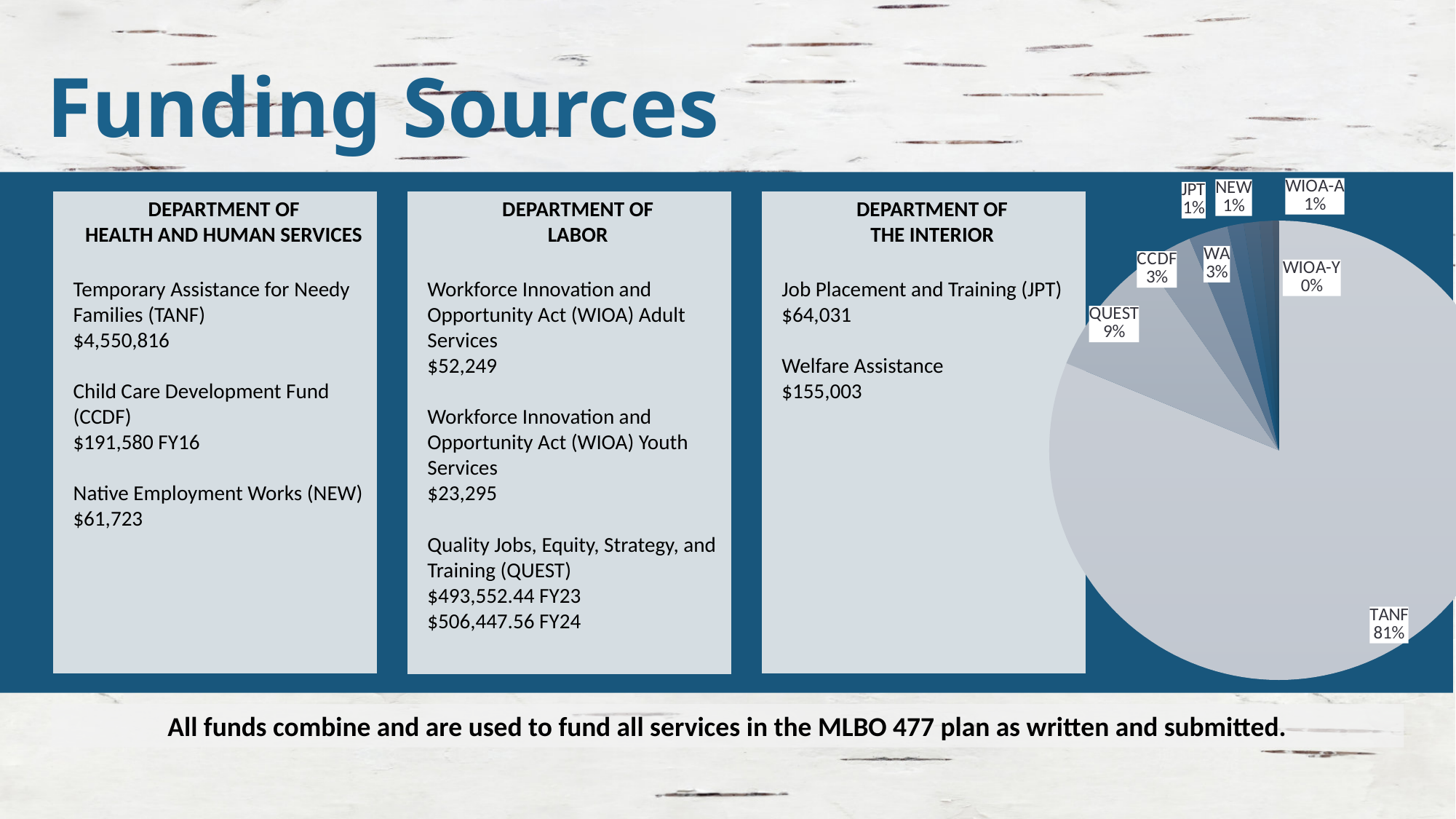
Which slice of the pie chart has the smallest labeled percentage? WIOA-Y Which is larger in the pie chart, QUEST or CCDF? QUEST How many slices are labeled in the pie chart? 8 What percentage is shown for JPT in the pie chart? 1% What kind of chart is shown on the slide? pie chart What percentage is shown for WA in the pie chart? 3% Which slice of the pie chart is the largest? TANF What is the difference in percentage points between TANF and QUEST in the pie chart? 72 What share of the pie does TANF represent? 81% What percentage is shown for WIOA-Y in the pie chart? 0% What percentage is shown for QUEST in the pie chart? 9% What percentage is shown for CCDF in the pie chart? 3%